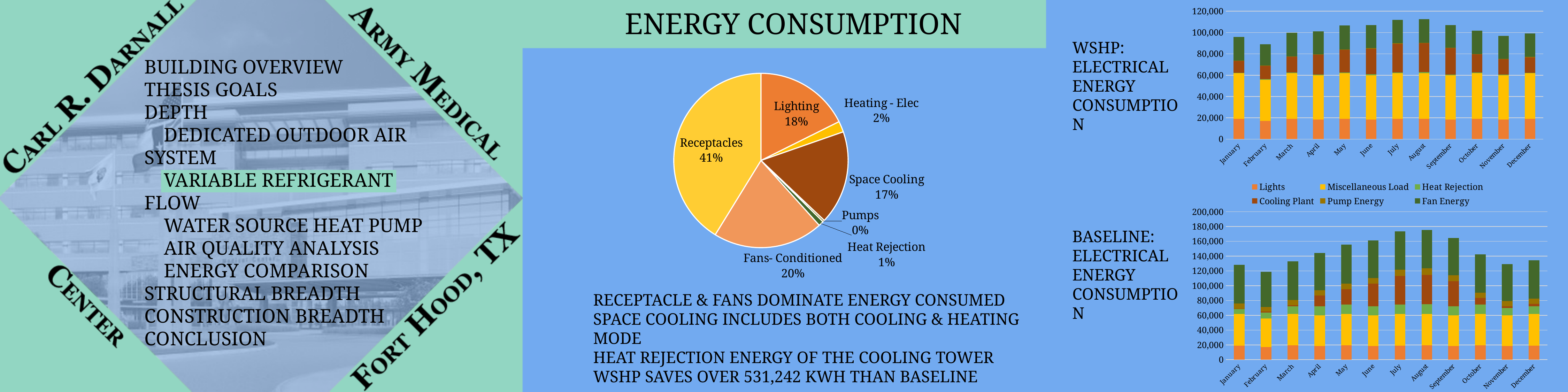
In the pie chart, what percentage is shown for Fans- Conditioned? 20% In the pie chart, what share of energy consumption is Receptacles? 41% How many slices does the pie chart have? 7 In the pie chart, what is the difference in percentage points between Lighting and Space Cooling? 1% In the pie chart, which category has the smallest share? Pumps How many series does the legend list for the WSHP and Baseline electrical energy consumption charts? 6 In the WSHP: Electrical Energy Consumption chart, is the total for August greater or less than 100,000? greater What kind of chart is the WSHP: Electrical Energy Consumption chart? Stacked bar chart In the pie chart, which category has the largest share? Receptacles In the pie chart, which is larger, Heating - Elec or Heat Rejection? Heating - Elec In the WSHP: Electrical Energy Consumption chart, which month has the lowest total? February In the Baseline: Electrical Energy Consumption chart, is the total for February greater or less than 140,000? less